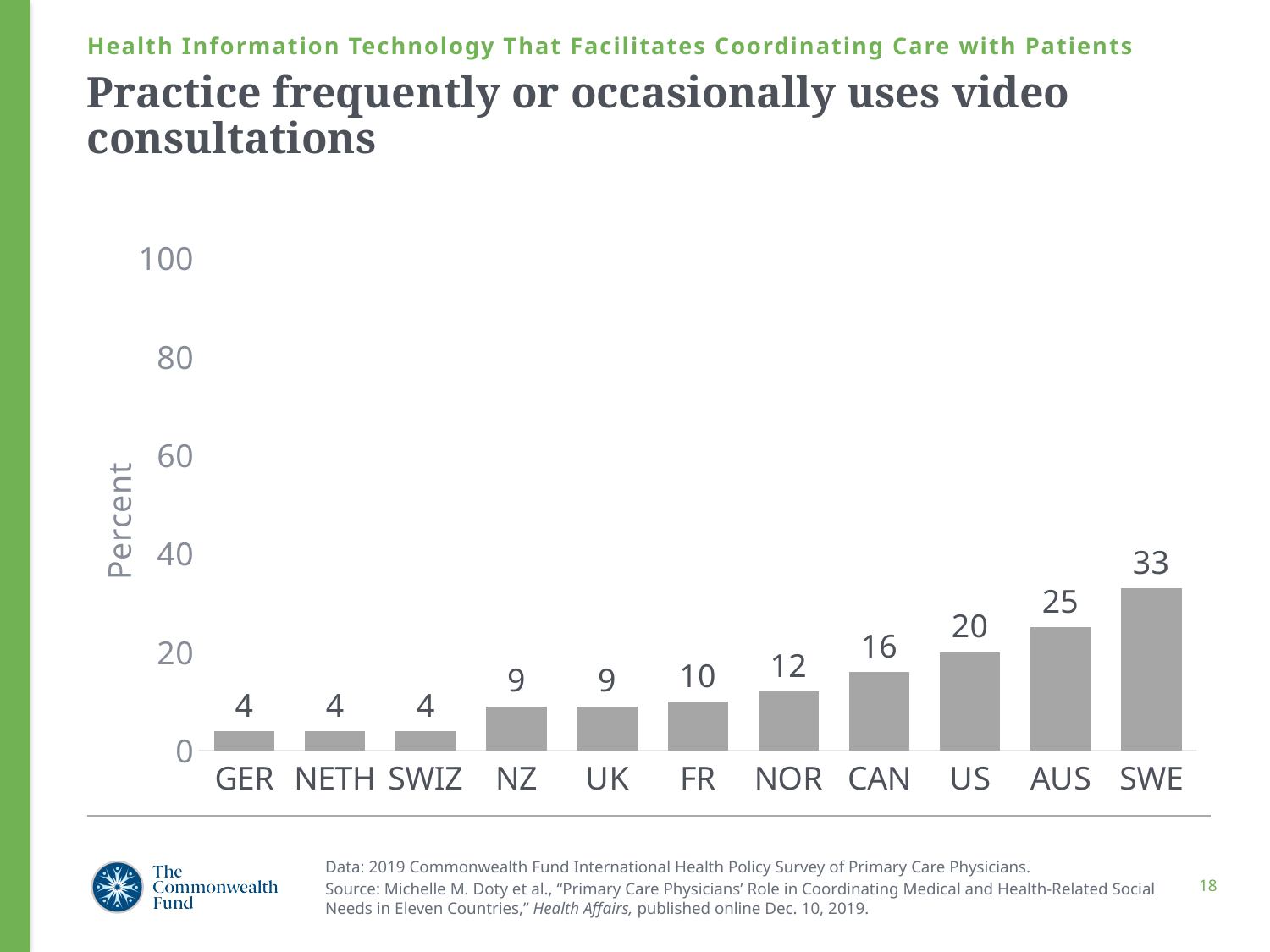
How many countries are shown on the x axis? 11 What is the label of the y axis? Percent Which country has the highest value? SWE What is the value for NOR? 12 What is the difference between the values for US and GER? 16 What kind of chart is shown on the slide? bar chart What is the value for SWE? 33 Is the value for AUS greater or less than 20? greater Do the values rise or fall from left to right along the x axis? rise What is the value for CAN? 16 What is the difference between the values for SWE and AUS? 8 Which is larger, the value for FR or the value for CAN? CAN